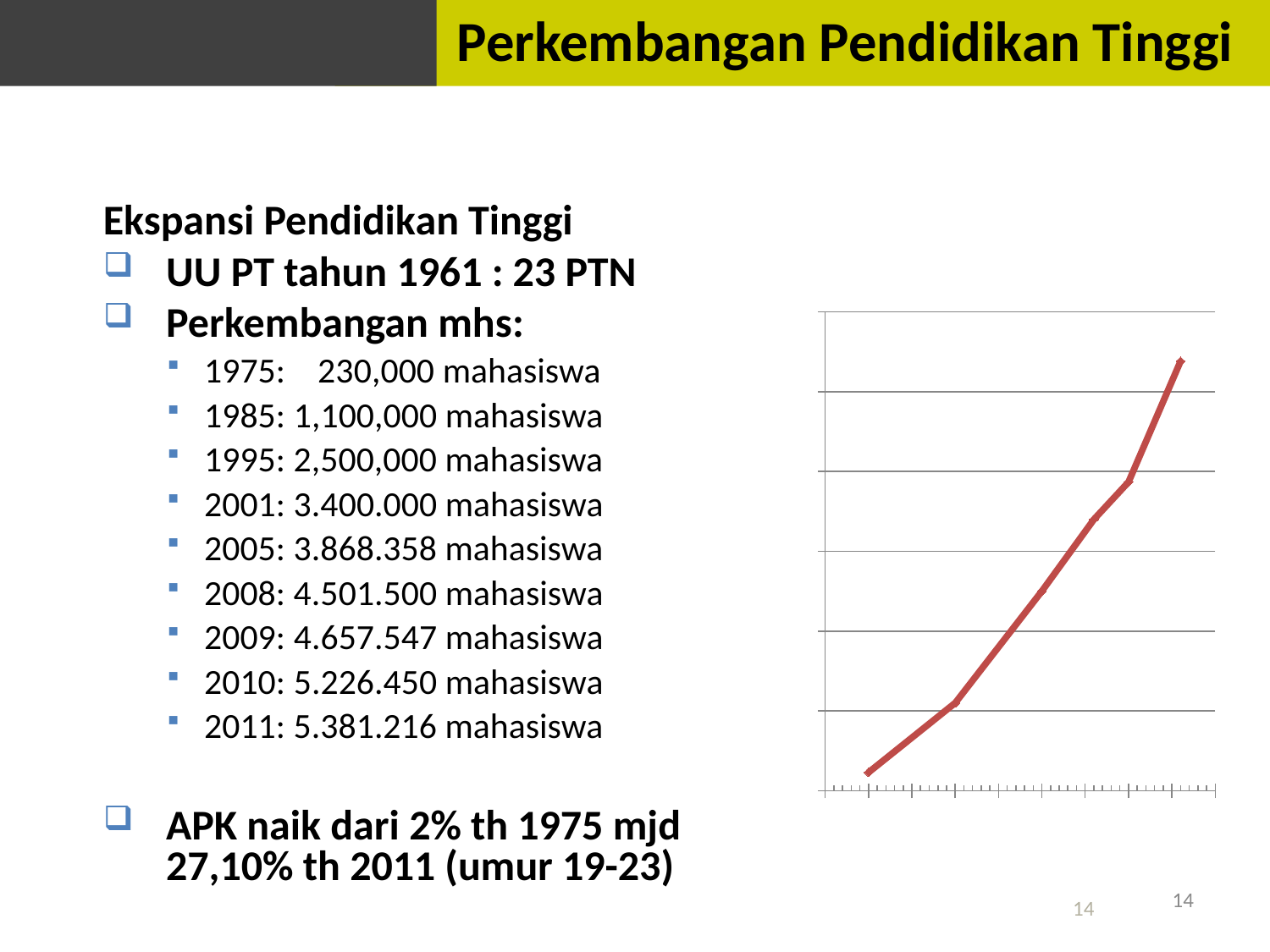
What kind of chart is shown on the right side of the slide? line chart How many lines are plotted in the chart? 1 Do the values in the line chart rise or fall from left to right? rise Is the right end of the line higher or lower than its left end? higher Does the line chart display any data labels on its points? No What colour is the line in the chart? red